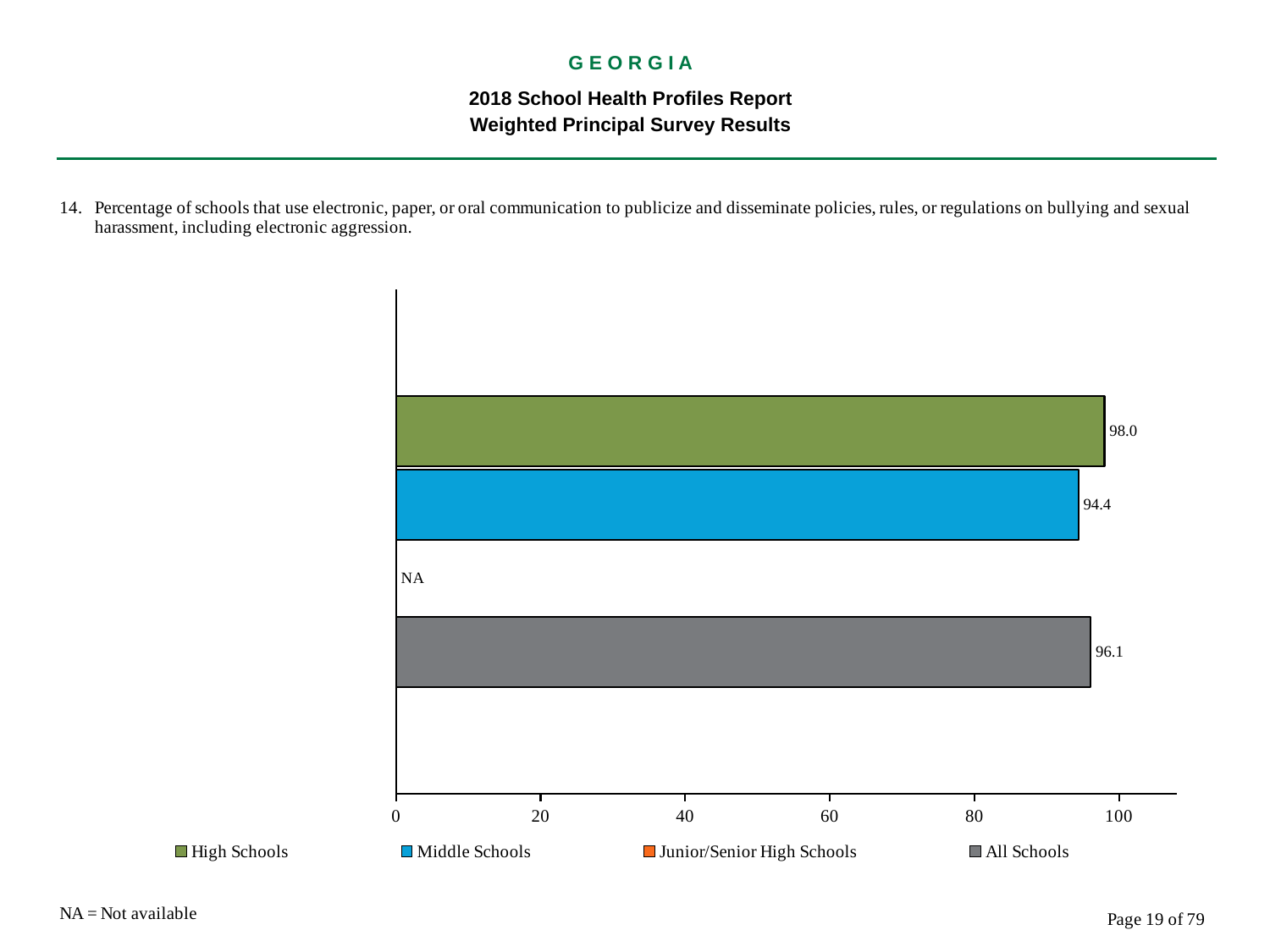
Among the school types with a plotted value, which has the lowest value? Middle Schools Which school type has the highest value? High Schools Which is larger, the value for All Schools or the value for Middle Schools? All Schools How many series does the legend list? 4 What kind of chart is shown on the slide? Bar chart What is the value for All Schools? 96.1 What is the difference between the High Schools value and the Middle Schools value? 3.6 What is the value for Middle Schools? 94.4 What is the value for High Schools? 98.0 Is the value for Middle Schools greater or less than 80? greater What is shown for Junior/Senior High Schools? NA What does NA stand for according to the note on the slide? Not available